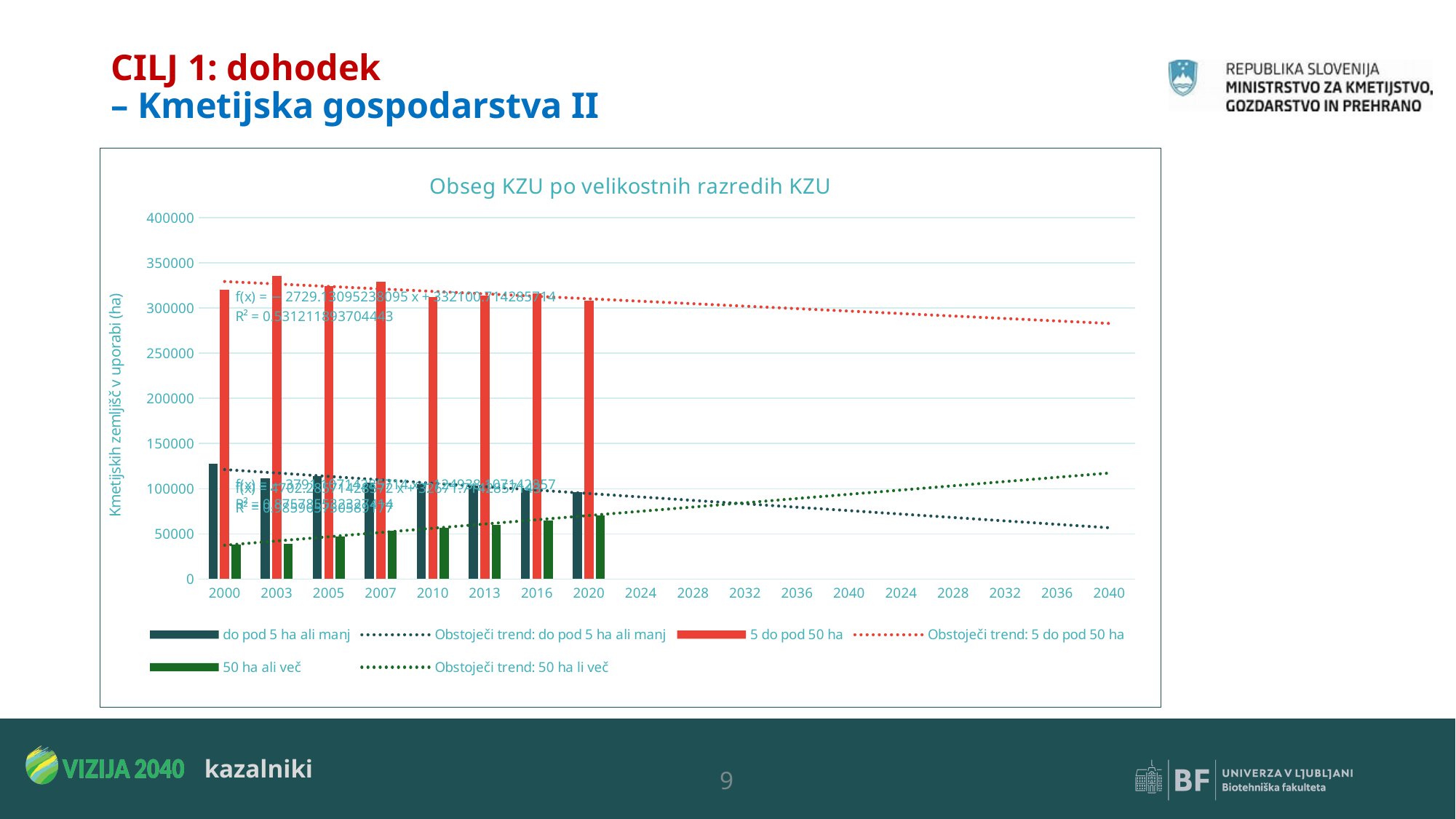
Is the value for '50 ha ali več' in 2000 greater or less than 50000? less In which year is the bar for '5 do pod 50 ha' the highest? 2003 In which year is the bar for 'do pod 5 ha ali manj' the highest? 2000 In which year is the bar for '50 ha ali več' the lowest? 2000 How many entries does the chart legend list? 6 In 2020, which is larger: the bar for 'do pod 5 ha ali manj' or the bar for '50 ha ali več'? do pod 5 ha ali manj For how many years are bars plotted in the chart? 8 What kind of chart is shown on the slide? bar chart Is the value for 'do pod 5 ha ali manj' in 2000 greater or less than 100000? greater What is the title of the chart? Obseg KZU po velikostnih razredih KZU Do the bars for '50 ha ali več' rise or fall from 2000 to 2020? rise Is the value for '5 do pod 50 ha' in 2000 greater or less than 300000? greater